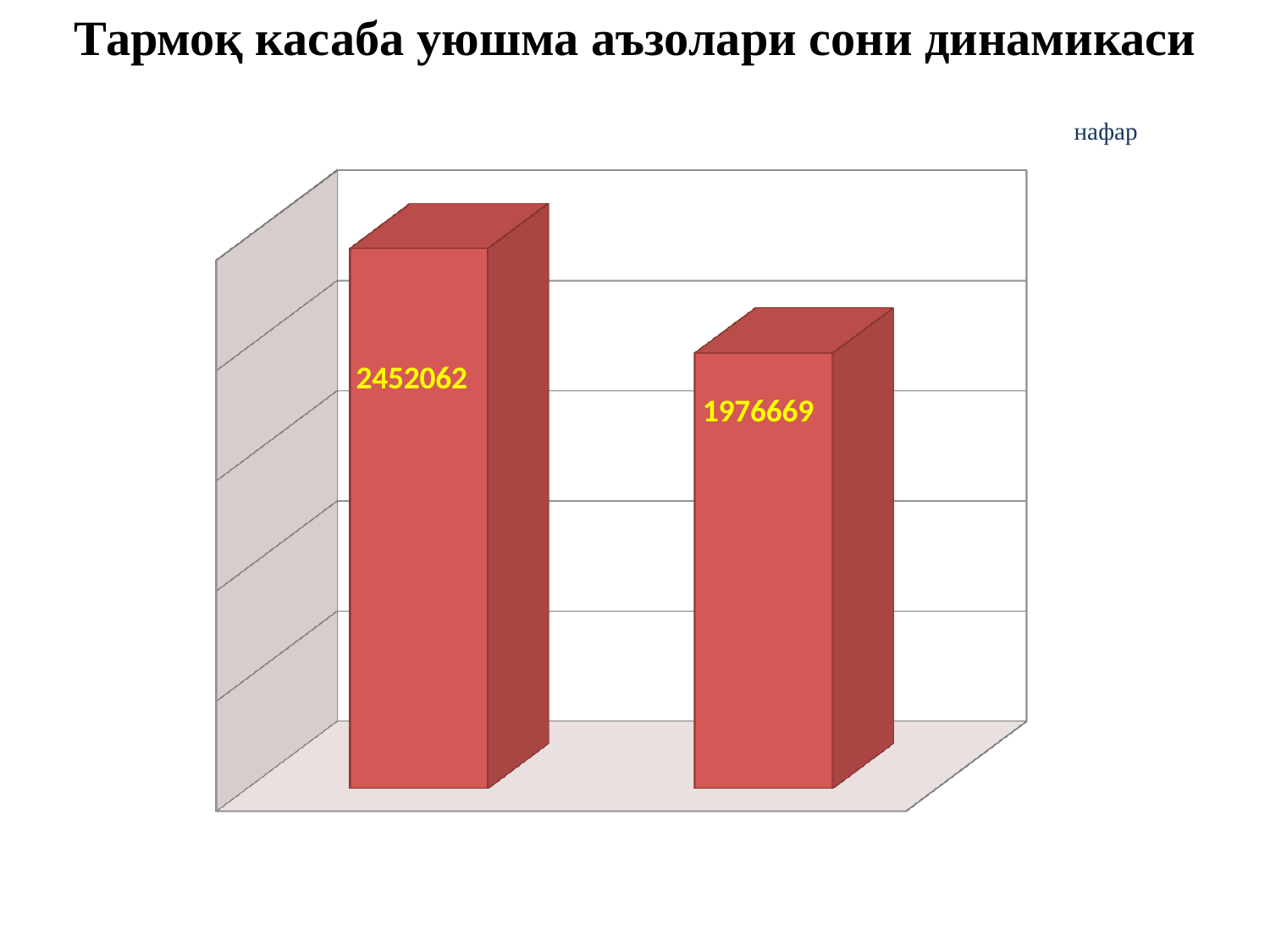
Do the values rise or fall from the left bar to the right bar? fall How many bars are plotted in the chart? 2 What kind of chart is shown on the slide? bar chart What is the difference between the left bar's value and the right bar's value? 475393 Is the value of the left bar larger or smaller than the value of the right bar? larger Which bar has the higher value, the left or the right one? the left bar What is the value shown on the right bar? 1976669 What unit label is shown above the chart on the right? нафар Which bar has the lower value, the left or the right one? the right bar What is the value shown on the left bar? 2452062 What is the title of the slide? Тармоқ касаба уюшма аъзолари сони динамикаси